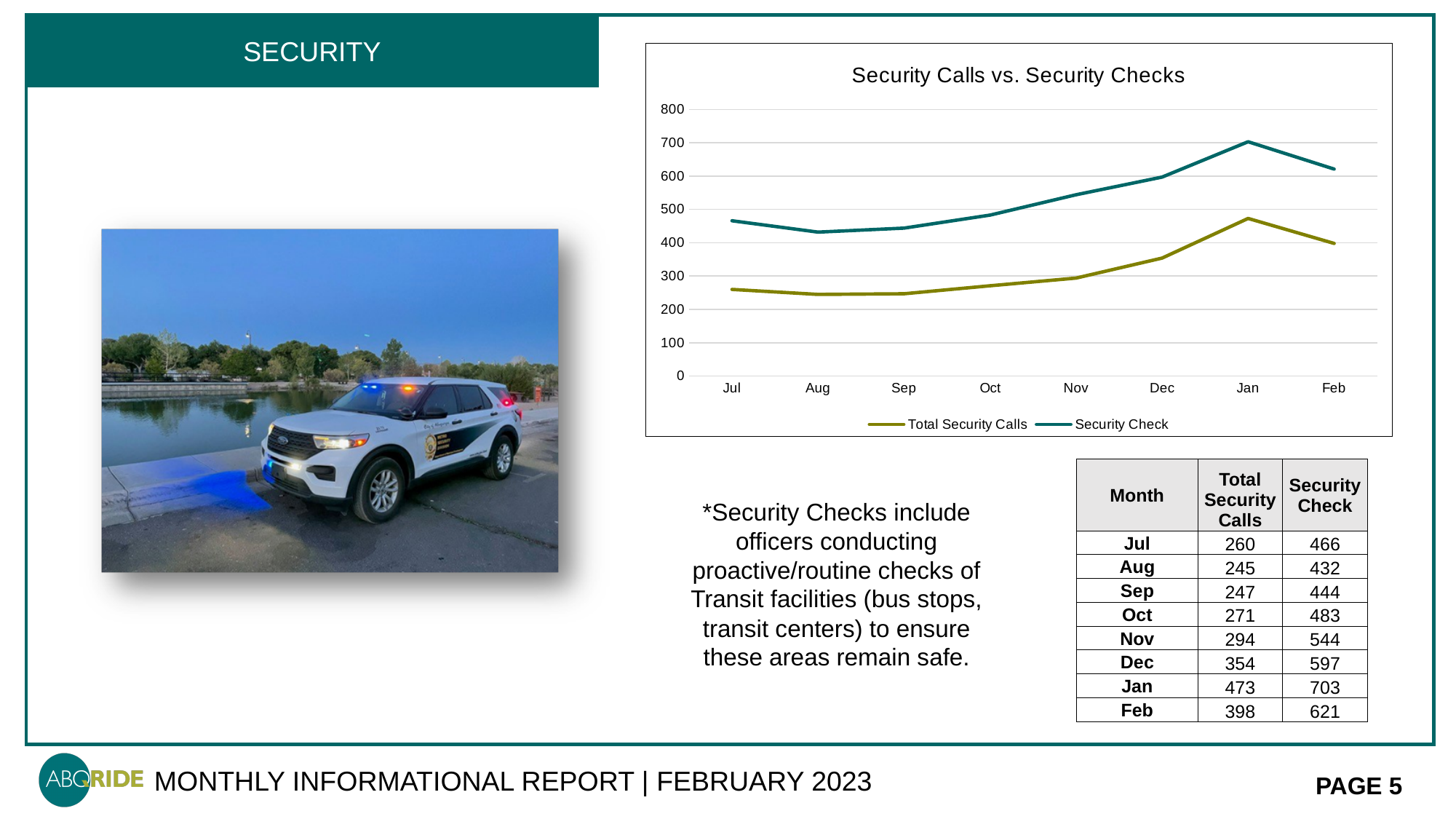
What type of chart is shown on the slide? line chart Is the value of Security Check for Nov greater or less than 500? greater Which is larger in Dec: Total Security Calls or Security Check? Security Check How many series does the chart legend list? 2 How many months are plotted along the x axis of the chart? 8 What is the title of the chart? Security Calls vs. Security Checks In which month is Total Security Calls highest? Jan What is the difference between Security Check and Total Security Calls in Feb? 223 What is the value of Security Check for Jan? 703 Does Total Security Calls rise or fall from Dec to Jan? rise In which month is Security Check lowest? Aug What is the value of Total Security Calls for Aug? 245